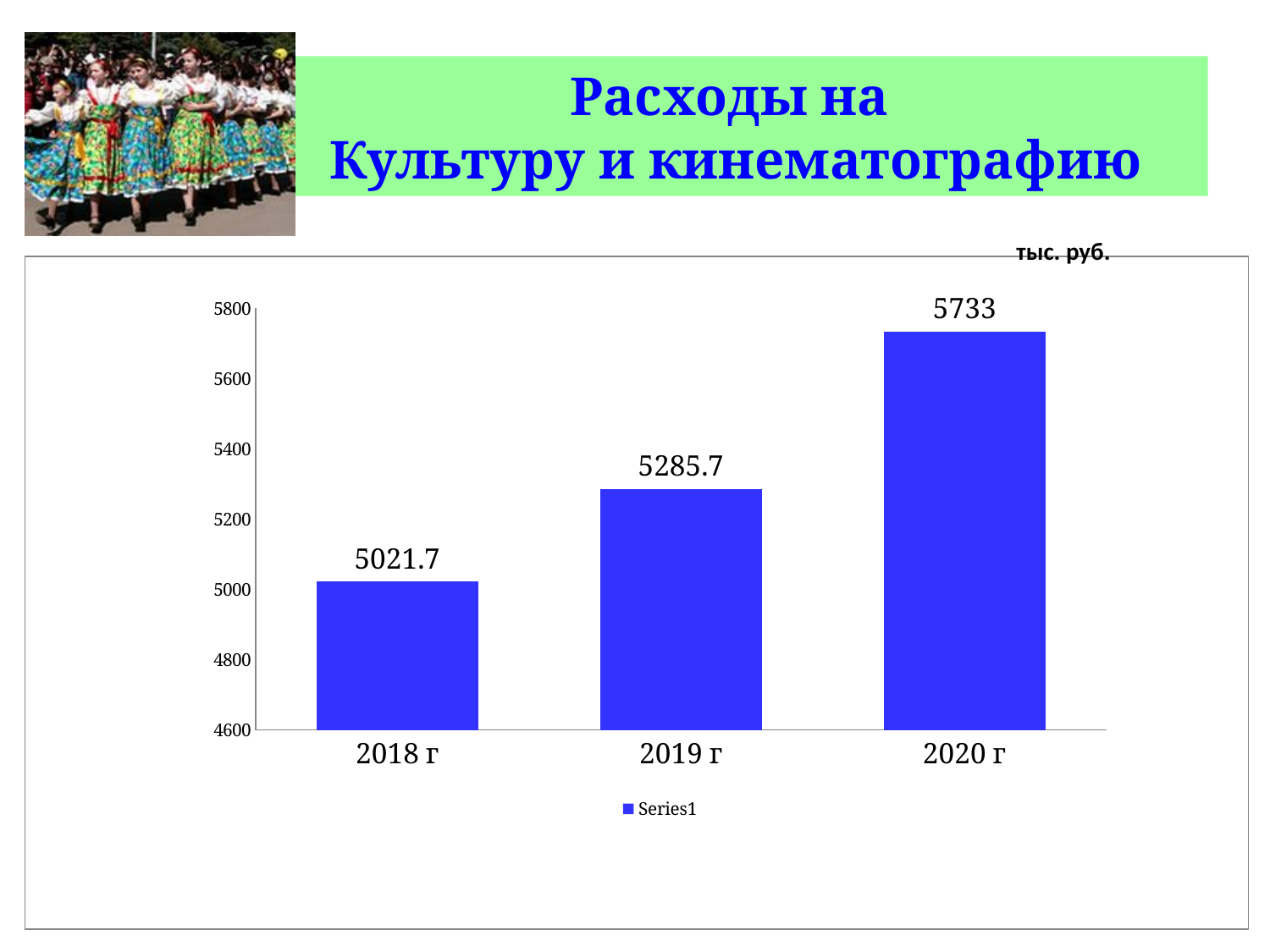
What kind of chart is shown on the slide? bar chart How many years are shown on the chart? 3 What is the difference between the values for 2020 г and 2018 г? 711.3 What is the value for 2019 г? 5285.7 Do the values rise or fall from 2018 г to 2020 г? rise What is the value for 2018 г? 5021.7 Which year has the highest value? 2020 г How many series does the legend list? 1 What is the value for 2020 г? 5733 What is the difference between the values for 2019 г and 2018 г? 264 Which is larger, the value for 2019 г or the value for 2020 г? 2020 г Which year has the lowest value? 2018 г